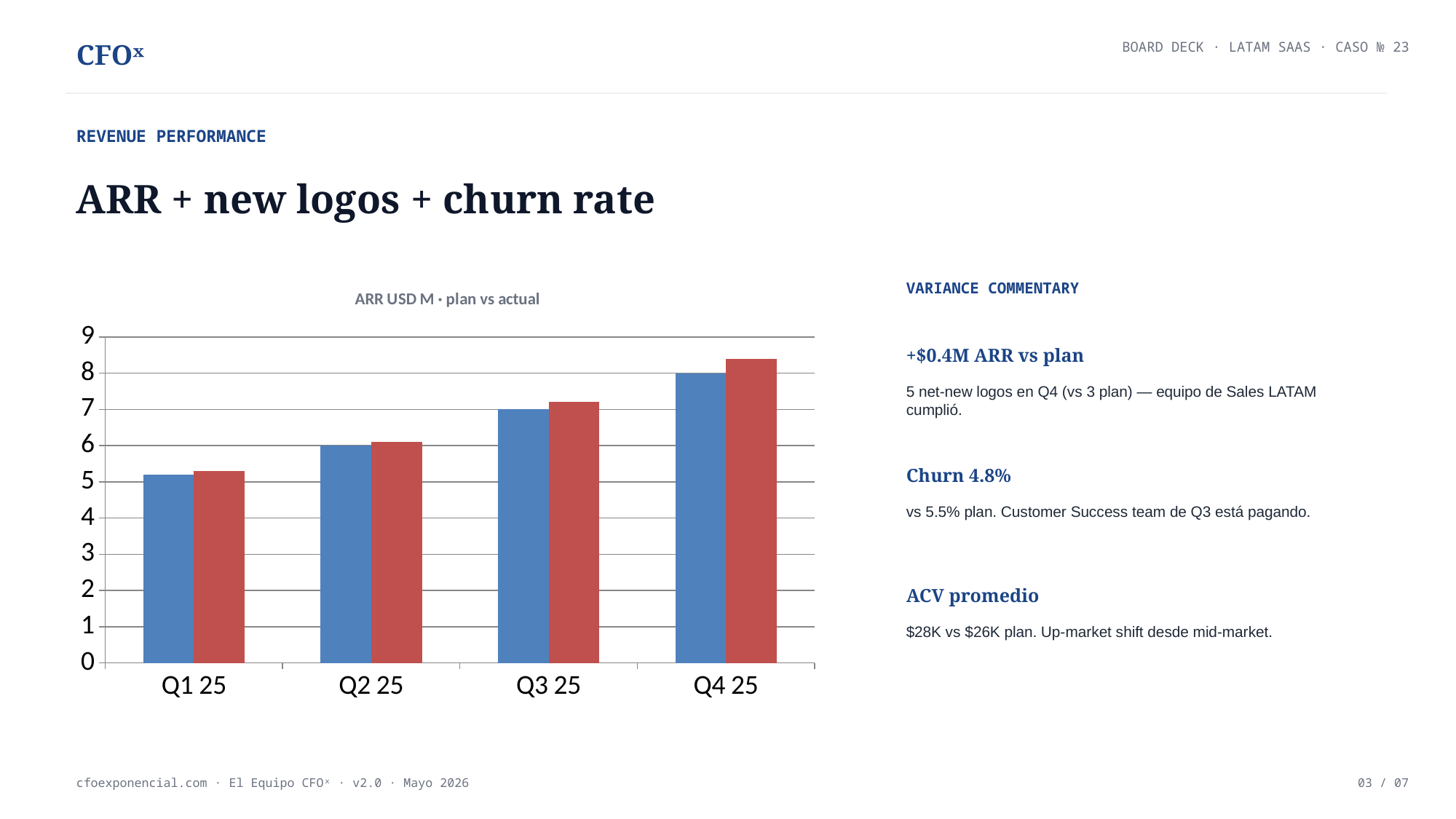
How many quarters are shown on the x axis of the chart? 4 Which quarter has the shortest bars in the chart? Q1 25 What is the title of the chart? ARR USD M · plan vs actual Is the value of the blue bar for Q1 25 greater or less than 6? less What kind of chart is shown on the slide? bar chart Which is larger, the blue bar for Q4 25 or the blue bar for Q1 25? Q4 25 Is the value of the red bar for Q4 25 greater or less than 8? greater Which quarter has the tallest bars in the chart? Q4 25 What is the value of the blue bar for Q2 25? 6 Do the bar values rise or fall from Q1 25 to Q4 25? rise What is the value of the blue bar for Q3 25? 7 What is the value of the blue bar for Q4 25? 8